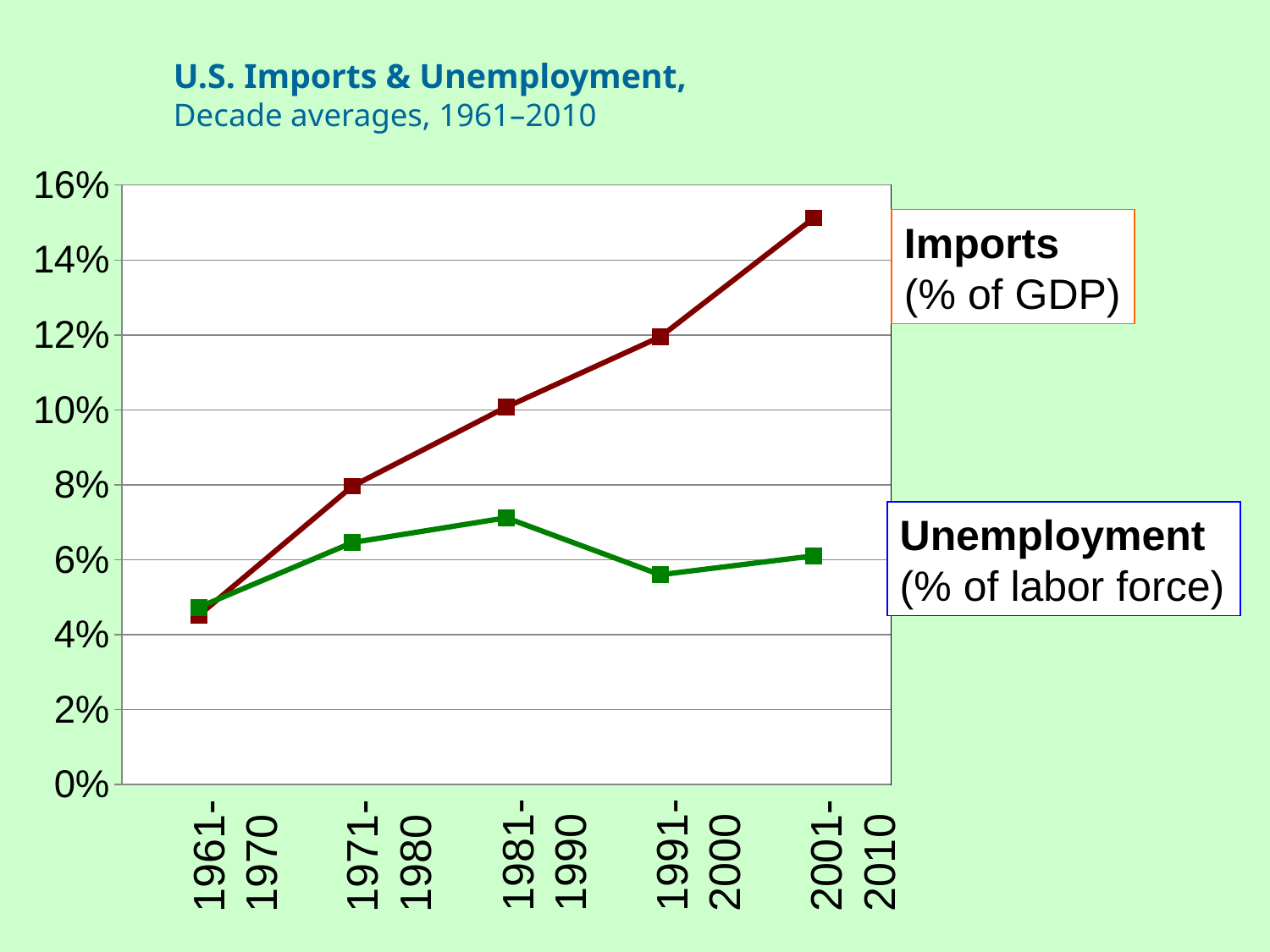
In which decade is Imports (% of GDP) highest? 2001-2010 What kind of chart is shown on the slide? line chart Which is larger in 2001-2010, Imports or Unemployment? Imports How many series does the chart plot? 2 Is the value for Imports in 2001-2010 greater or less than 14%? greater How many decade periods are shown on the x axis? 5 Do the Imports values rise or fall across the decades from 1961-1970 to 2001-2010? rise In which decade is Unemployment (% of labor force) lowest? 1961-1970 Is the value for Unemployment in 1991-2000 greater or less than 6%? less Is the value for Unemployment in 1981-1990 greater or less than 6%? greater In which decade is Unemployment (% of labor force) highest? 1981-1990